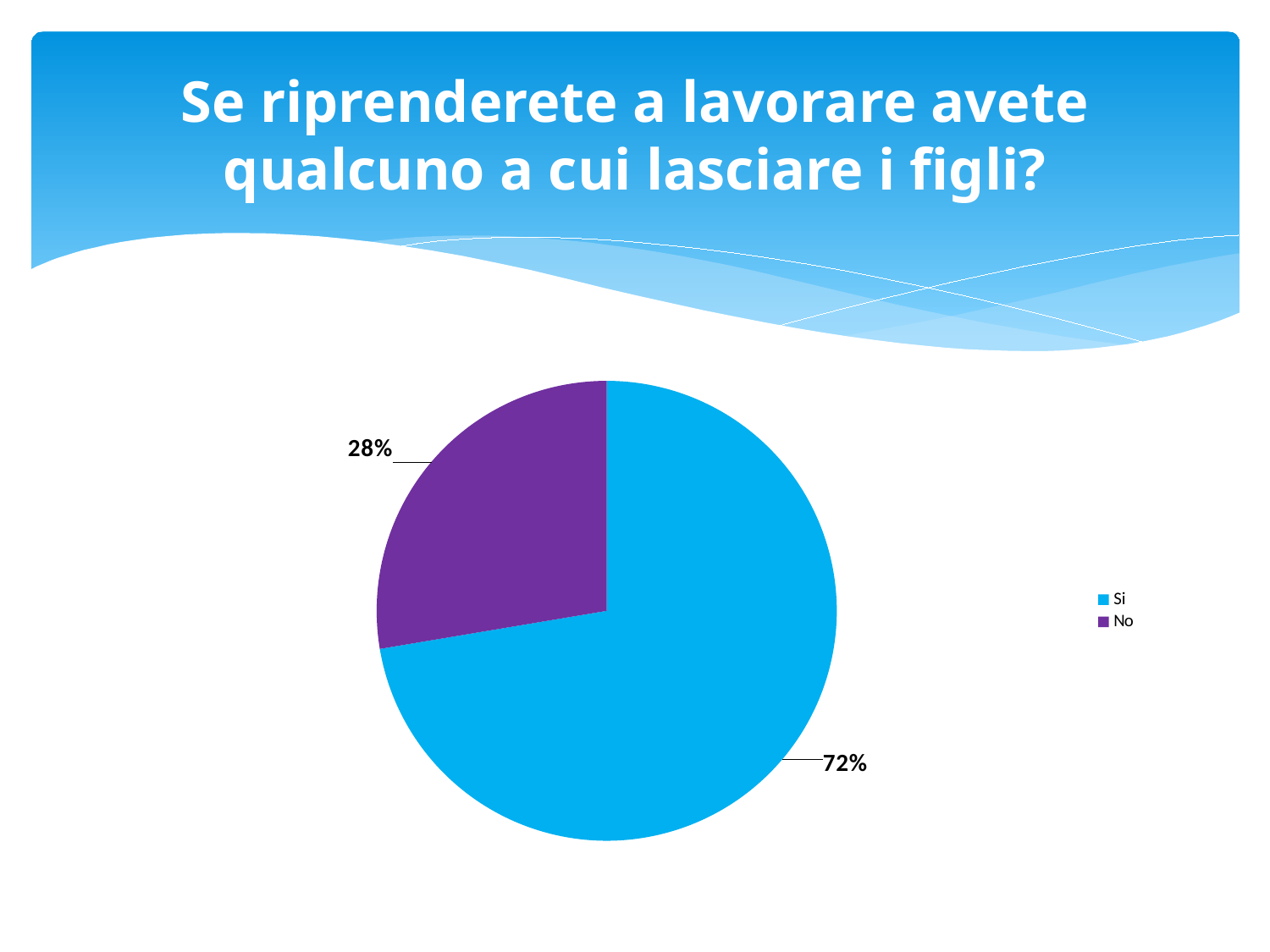
What is the title of the slide containing the pie chart? Se riprenderete a lavorare avete qualcuno a cui lasciare i figli? Which category has the smallest slice of the pie? No What colour is the "No" slice in the pie chart? purple How many slices does the pie chart have? 2 Which category has the largest slice of the pie? Si How many entries does the legend list? 2 What share of the pie does the "Si" slice represent? 72% Which is larger, the "Si" slice or the "No" slice? Si What is the difference in percentage points between the "Si" and "No" slices? 44 What kind of chart is shown on the slide? pie chart What share of the pie does the "No" slice represent? 28%